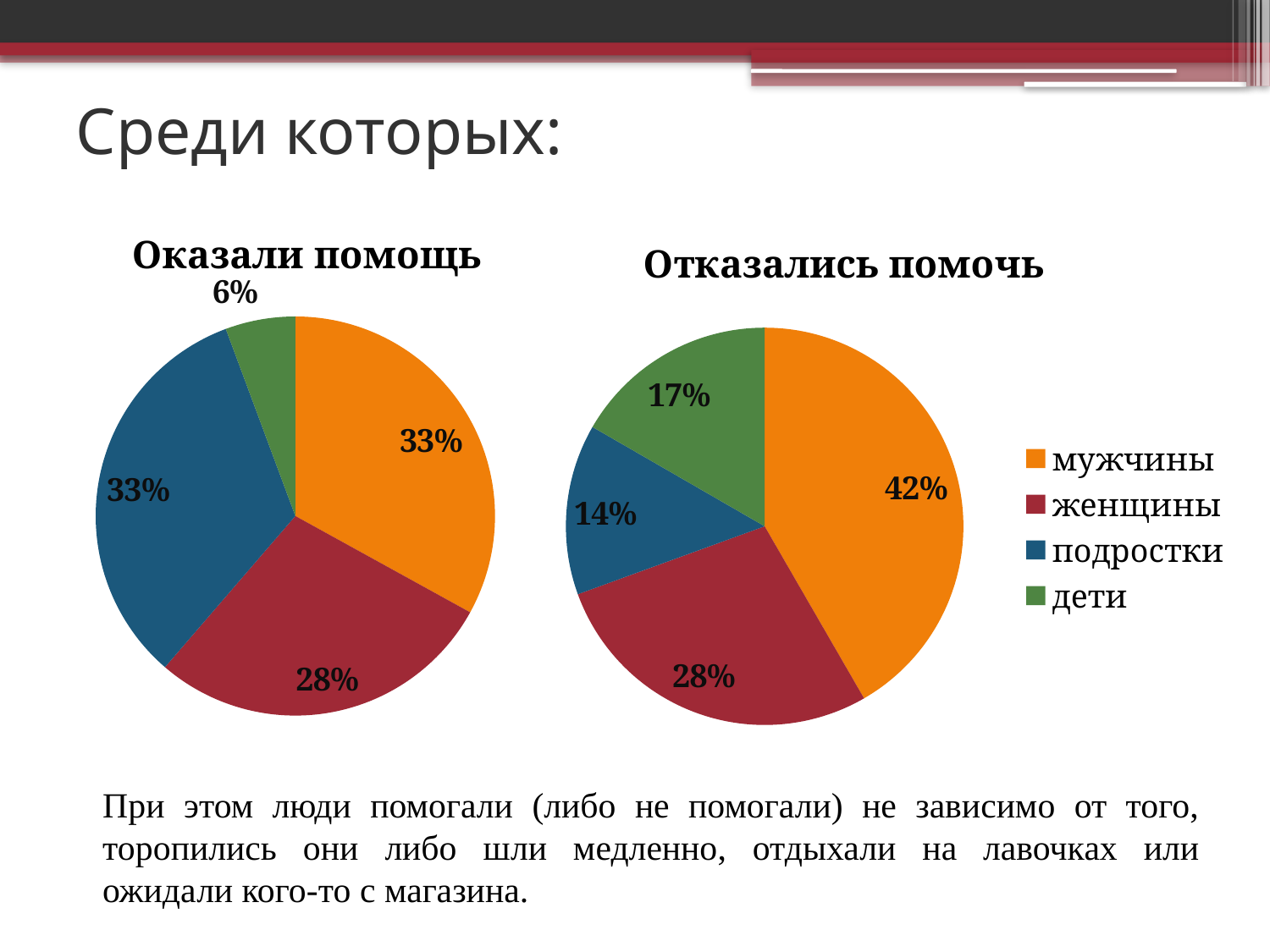
In the 'Отказались помочь' chart, what share is labelled for мужчины? 42% In the 'Отказались помочь' chart, which category has the smallest slice? подростки In the 'Оказали помощь' chart, which category has the smallest slice? дети How many categories does the legend list? 4 In the 'Отказались помочь' chart, which category has the largest slice? мужчины In the 'Отказались помочь' chart, what share is labelled for подростки? 14% In the 'Оказали помощь' chart, what share is labelled for женщины? 28% In the 'Отказались помочь' chart, what share is labelled for дети? 17% In the 'Отказались помочь' chart, which is larger: the slice for дети or the slice for подростки? дети In the 'Оказали помощь' chart, what share is labelled for дети? 6% What is the difference between the share for мужчины in the 'Отказались помочь' chart and the share for мужчины in the 'Оказали помощь' chart? 9% What type of chart is used for 'Оказали помощь'? pie chart